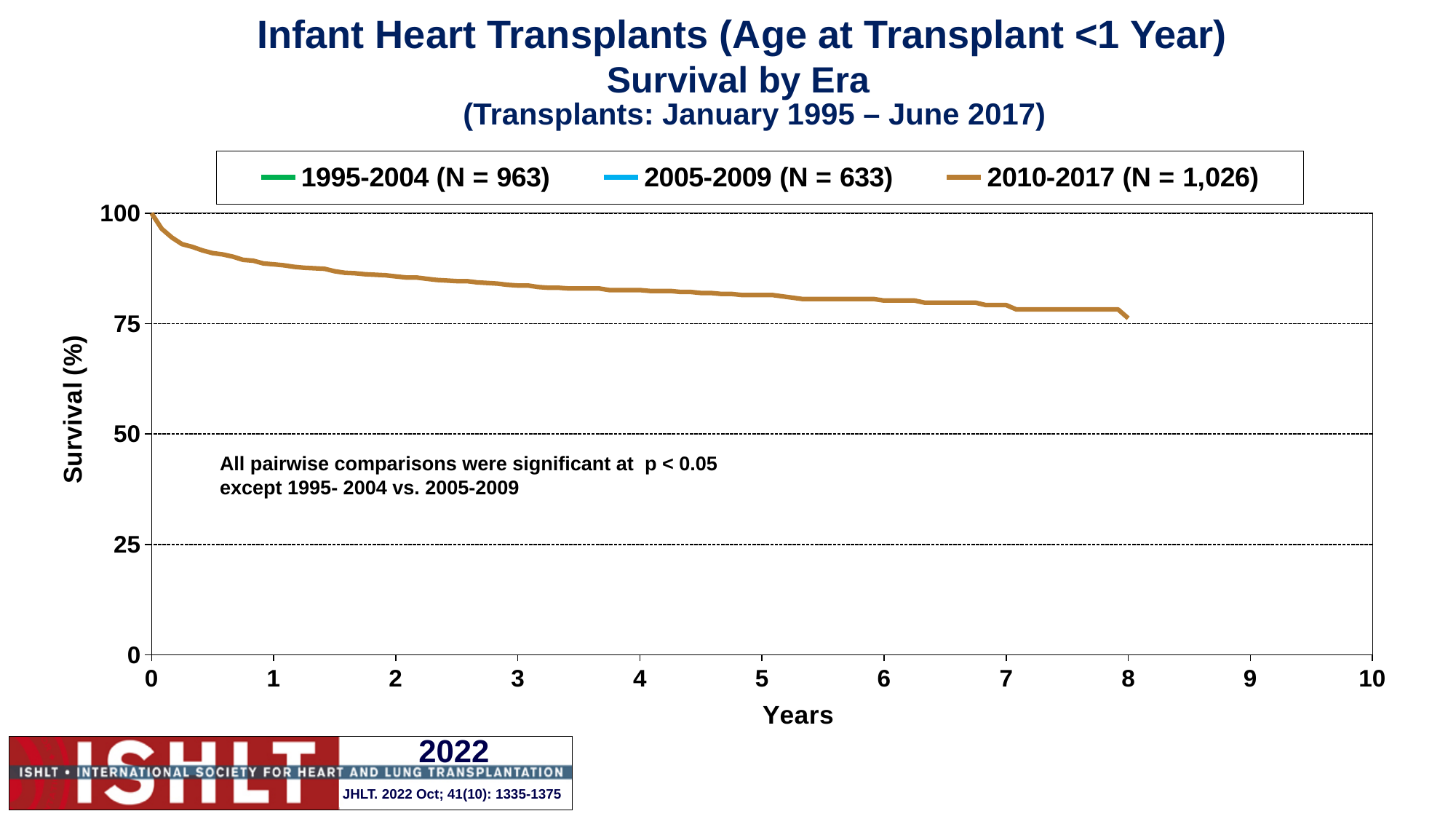
At what year on the x axis does the plotted survival curve end? 8 What kind of chart is shown on the slide? line chart What is the N shown in the legend for the 2010-2017 series? 1,026 Is the survival value for the 2010-2017 series at year 2 greater or less than 75? greater What is the survival value for the 2010-2017 series at year 0? 100 Is the survival value for the 2010-2017 series at year 6 greater or less than 50? greater How many series does the legend list? 3 Which series is drawn as the brown line on the chart? 2010-2017 (N = 1,026) Does the survival curve rise or fall as years increase? fall Is the survival value for the 2010-2017 series at year 4 greater or less than 75? greater